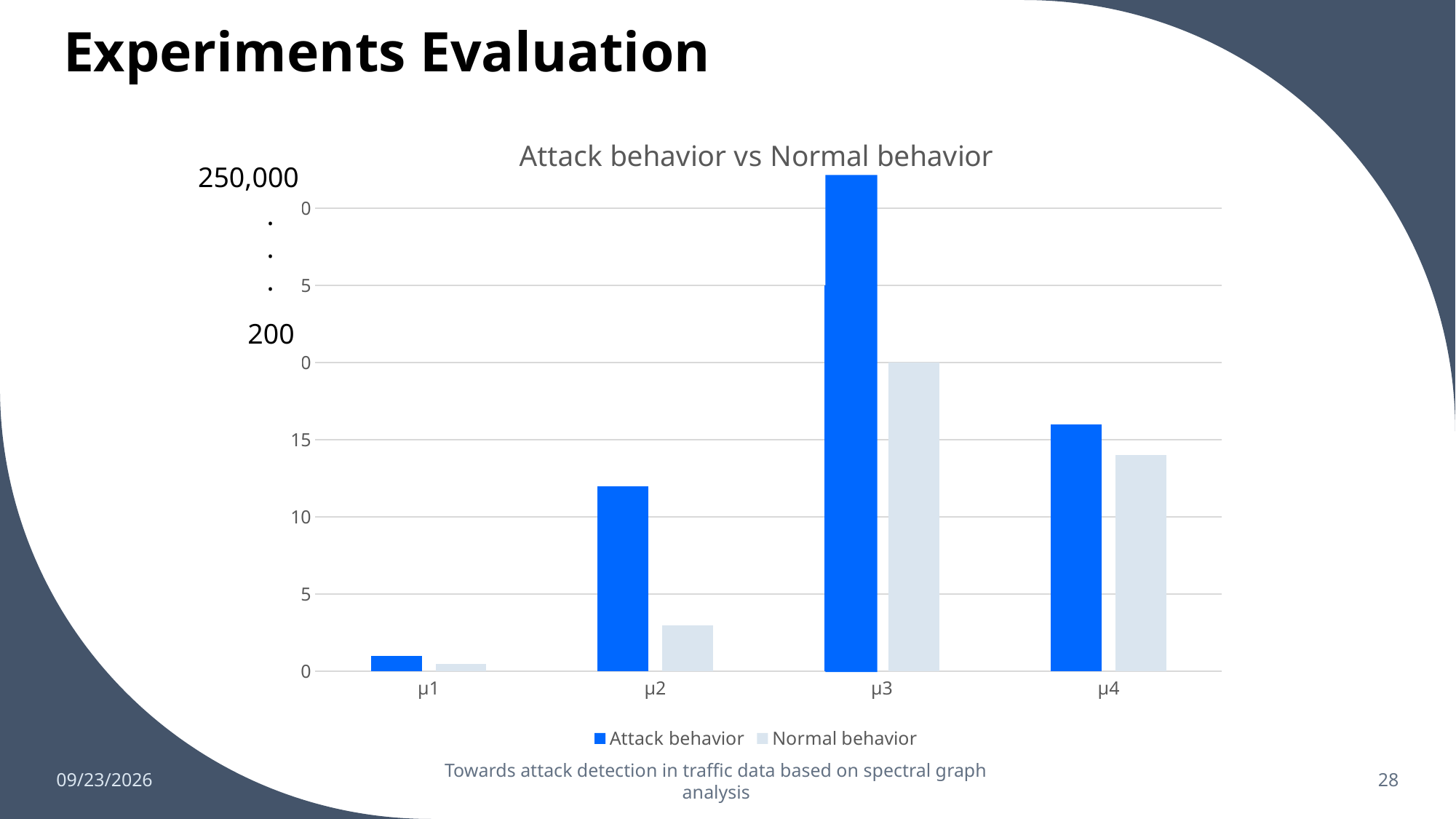
Is the Normal behavior value for μ2 greater or less than 5? less Is the Normal behavior value for μ4 greater or less than 15? less What kind of chart is shown on the slide? bar chart How many series does the chart legend list? 2 Which category has the lowest Normal behavior value? μ1 Which category has the highest Attack behavior value? μ3 Is the Attack behavior value for μ4 greater or less than 15? greater How many categories are shown on the x axis of the chart? 4 What is the title of the chart? Attack behavior vs Normal behavior Which series is drawn in the darker blue bars? Attack behavior For μ2, which series has the larger value, Attack behavior or Normal behavior? Attack behavior